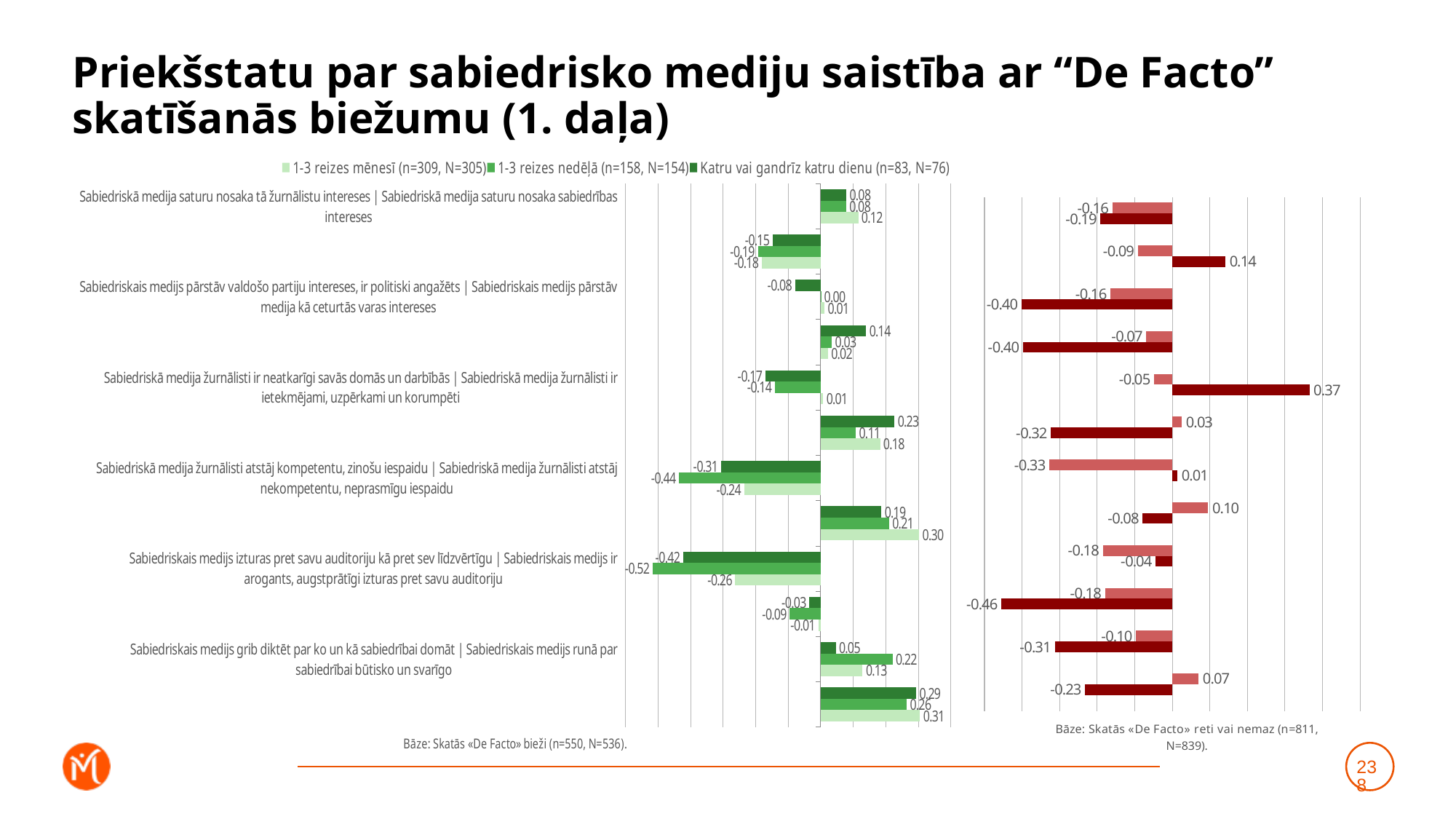
In the left (green) chart, what is the highest value printed on any bar? 0.31 In the left chart, what is the value of the '1-3 reizes mēnesī' bar in the topmost group (Sabiedriskā medija saturu nosaka tā žurnālistu intereses)? 0.12 What is the first legend entry of the left chart? 1-3 reizes mēnesī (n=309, N=305) What is the third legend entry of the left chart? Katru vai gandrīz katru dienu (n=83, N=76) Which is larger: the highest value in the right (red) chart, 0.37, or the highest value in the left (green) chart, 0.31? 0.37 (right chart) What kind of chart is shown on the left side of the slide? bar chart In the right (red) chart, what is the highest value printed on any bar? 0.37 In the left (green) chart, what is the lowest value printed on any bar? -0.52 In the left chart, what is the value of the 'Katru vai gandrīz katru dienu' bar in the topmost group (Sabiedriskā medija saturu nosaka tā žurnālistu intereses)? 0.08 What is the difference between the highest value in the right chart (0.37) and the highest value in the left chart (0.31)? 0.06 In the right (red) chart, what is the lowest value printed on any bar? -0.46 How many series does the legend of the left chart list? 3